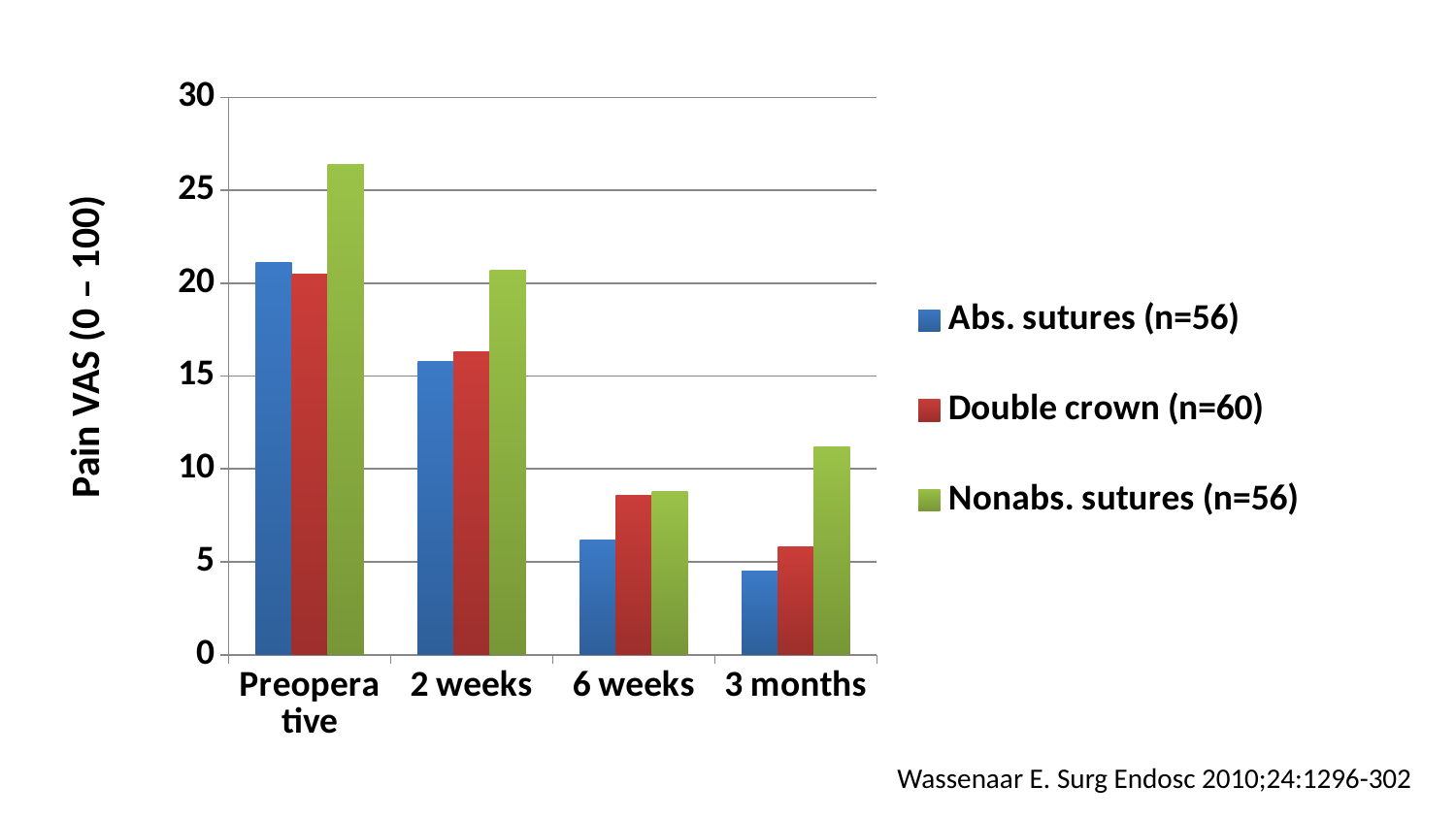
At 3 months, which is larger: Nonabs. sutures (n=56) or Double crown (n=60)? Nonabs. sutures (n=56) Is the Preoperative value for Nonabs. sutures (n=56) greater or less than 25? greater Do the Abs. sutures (n=56) values rise or fall from Preoperative to 3 months? fall What kind of chart is shown on the slide? bar chart What is the label of the y axis? Pain VAS (0 – 100) Is the 2 weeks value for Double crown (n=60) greater or less than 15? greater Is the 3 months value for Abs. sutures (n=56) greater or less than 5? less How many time-point categories are shown on the x axis? 4 At which time point is the Abs. sutures (n=56) value lowest? 3 months At which time point is the Nonabs. sutures (n=56) value highest? Preoperative How many series does the legend list? 3 Which series has the highest value at 2 weeks? Nonabs. sutures (n=56)